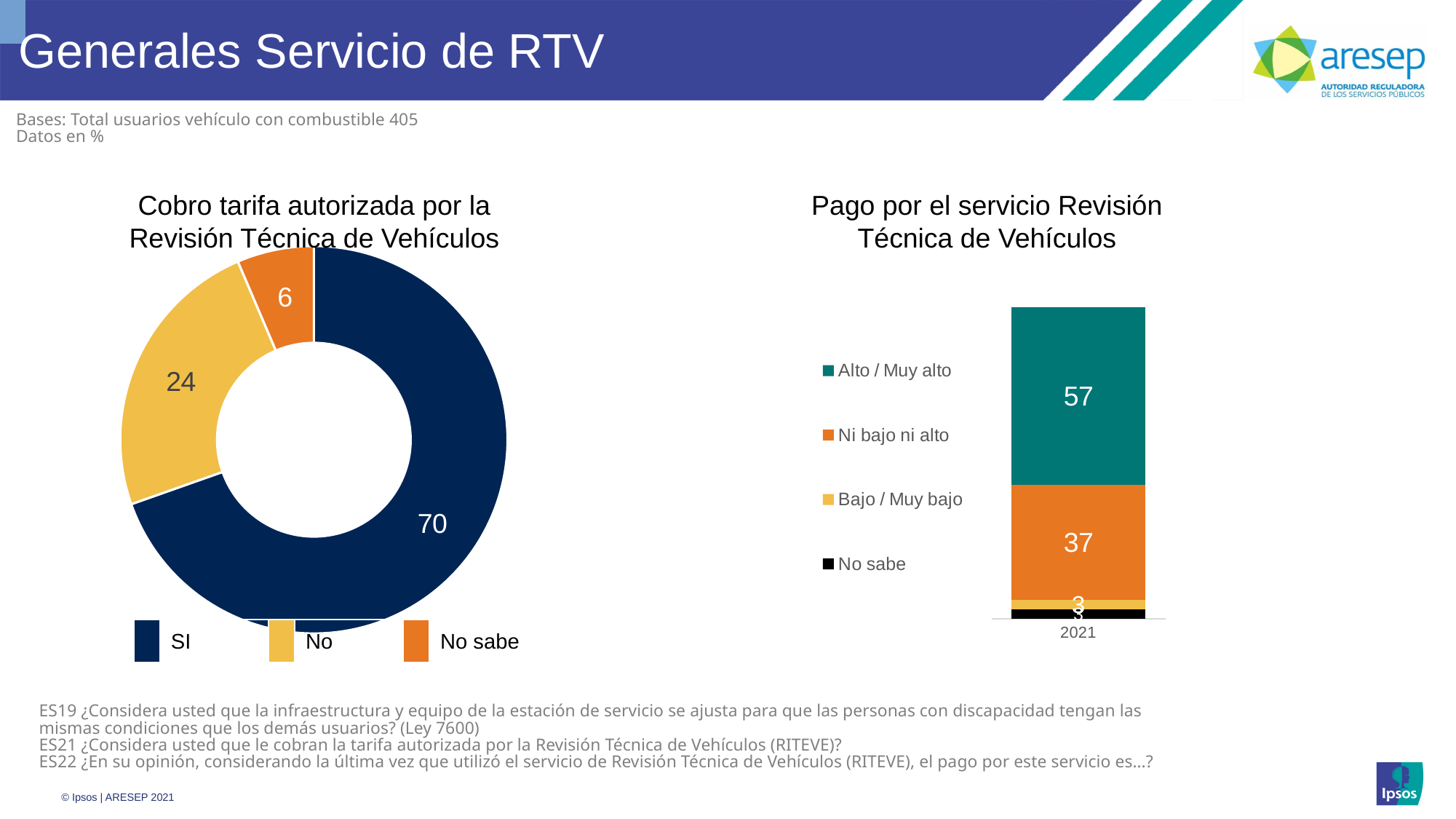
In the chart 'Pago por el servicio Revisión Técnica de Vehículos', what is the value for 'Alto / Muy alto'? 57 In the chart 'Cobro tarifa autorizada por la Revisión Técnica de Vehículos', which category has the smallest value? No sabe In the chart 'Cobro tarifa autorizada por la Revisión Técnica de Vehículos', what is the value for 'No'? 24 In the chart 'Cobro tarifa autorizada por la Revisión Técnica de Vehículos', what is the difference between the values for 'SI' and 'No'? 46 What kind of chart is 'Pago por el servicio Revisión Técnica de Vehículos'? Stacked bar chart In the chart 'Pago por el servicio Revisión Técnica de Vehículos', what is the total of the stacked bar for 2021? 100 What kind of chart is 'Cobro tarifa autorizada por la Revisión Técnica de Vehículos'? Pie (donut) chart In the chart 'Pago por el servicio Revisión Técnica de Vehículos', what is the value for 'Ni bajo ni alto'? 37 How many categories does the legend of the chart 'Cobro tarifa autorizada por la Revisión Técnica de Vehículos' list? 3 In the chart 'Pago por el servicio Revisión Técnica de Vehículos', how many series does the legend list? 4 In the chart 'Pago por el servicio Revisión Técnica de Vehículos', which series has the largest value? Alto / Muy alto In the chart 'Cobro tarifa autorizada por la Revisión Técnica de Vehículos', what is the value for 'SI'? 70